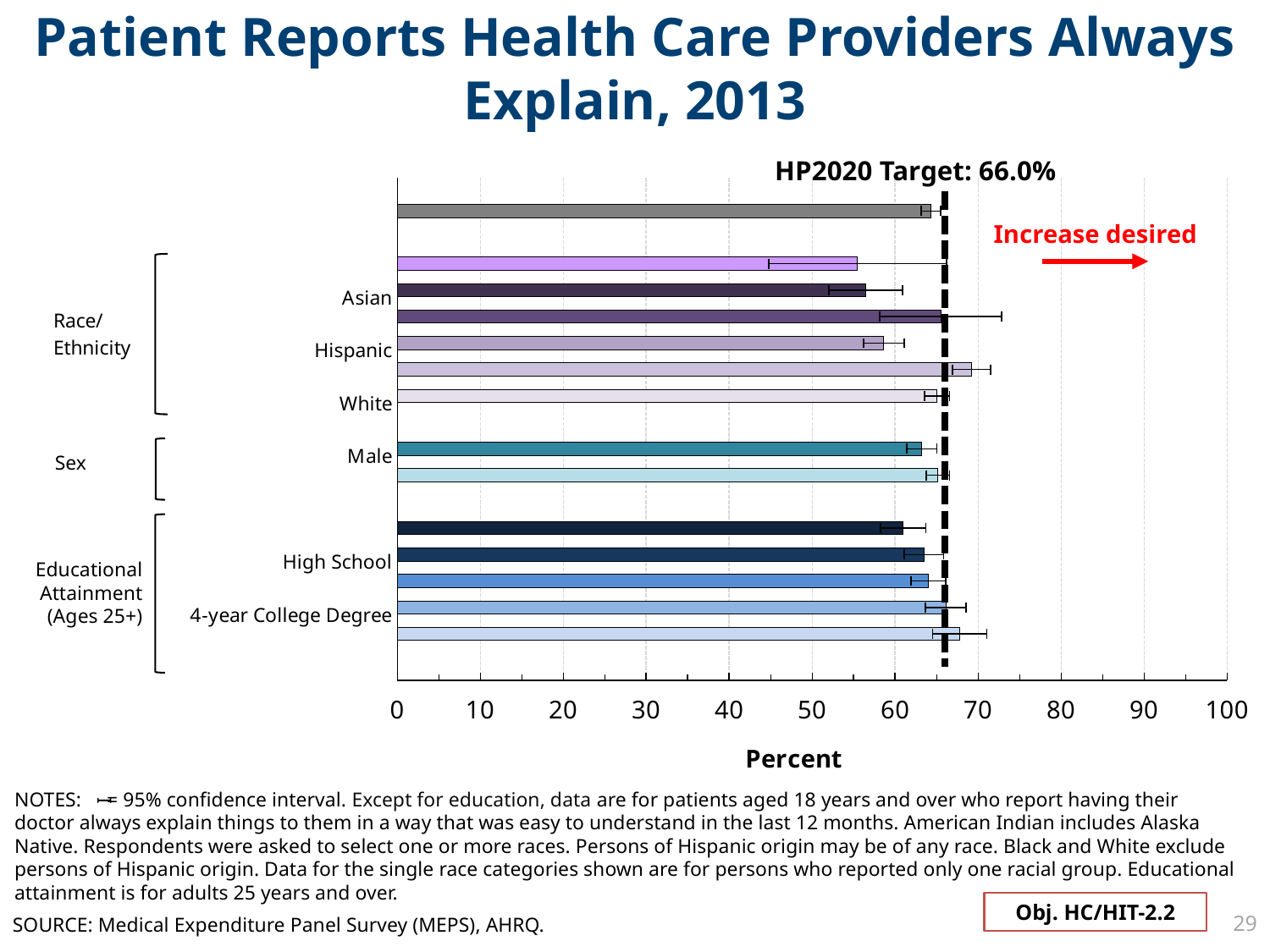
Is the value for High School greater or less than 60? greater Is the value for Hispanic greater or less than 70? less What is the label of the horizontal axis? Percent Is the value for Asian greater or less than 60? less What is the HP2020 Target value shown on the chart? 66.0% Which has the larger value, Asian or Male? Male Which has the larger value, Asian or White? White Which has the larger value, Hispanic or White? White What kind of chart is shown on the slide? bar chart